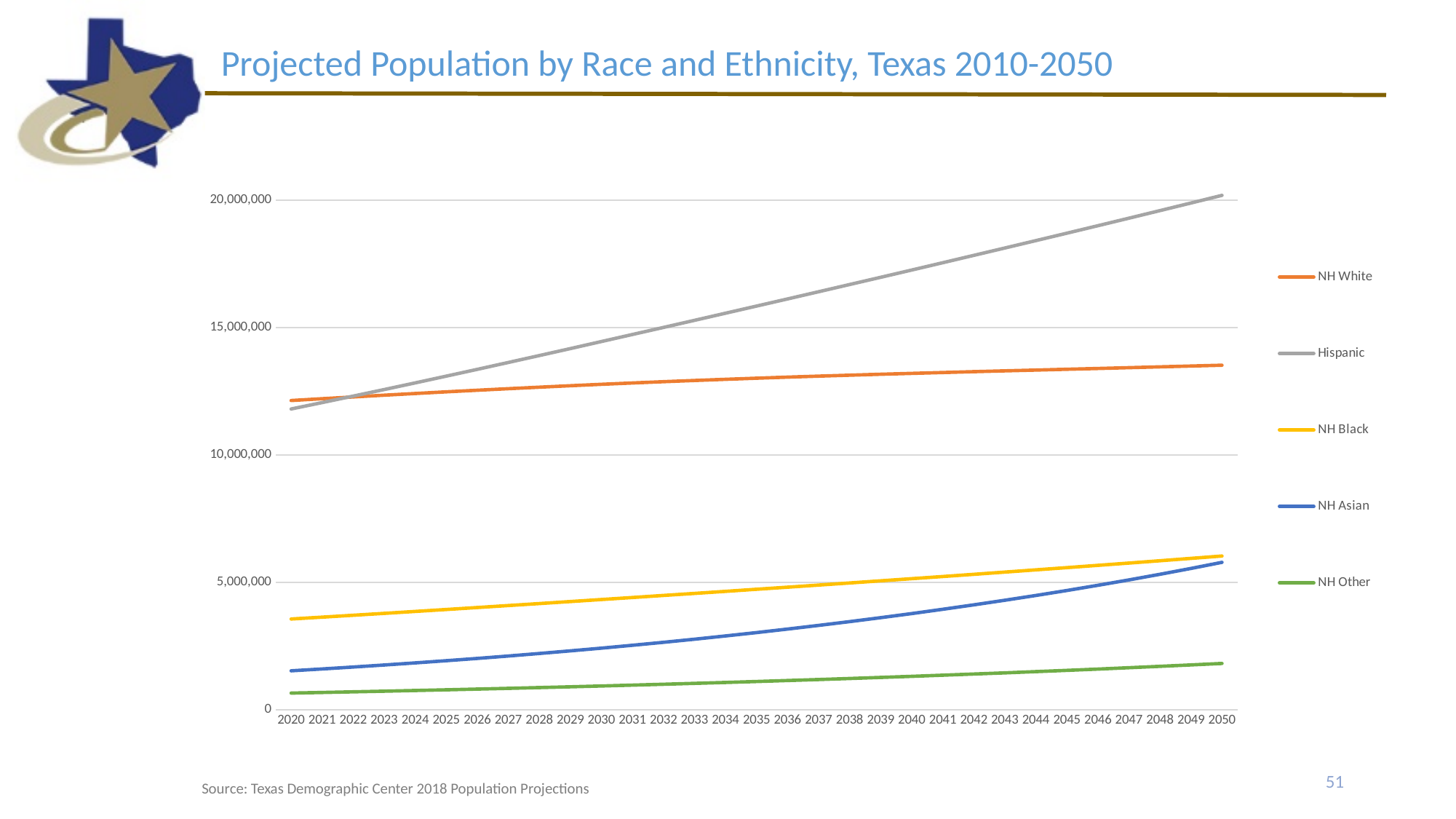
How many years are shown along the x axis? 31 Is the value for NH Asian in 2050 greater or less than 5,000,000? greater Which series has the highest value in 2050? Hispanic Which series has the lowest value in 2020? NH Other Is the value for NH White in 2050 greater or less than 15,000,000? less What kind of chart is shown on the slide? line chart In 2020, which is larger: NH Black or NH Asian? NH Black Which series has the lowest value in 2050? NH Other Does the Hispanic line rise or fall from 2020 to 2050? rise In 2050, which is larger: Hispanic or NH White? Hispanic How many series does the legend list? 5 Is the value for Hispanic in 2020 greater or less than 15,000,000? less